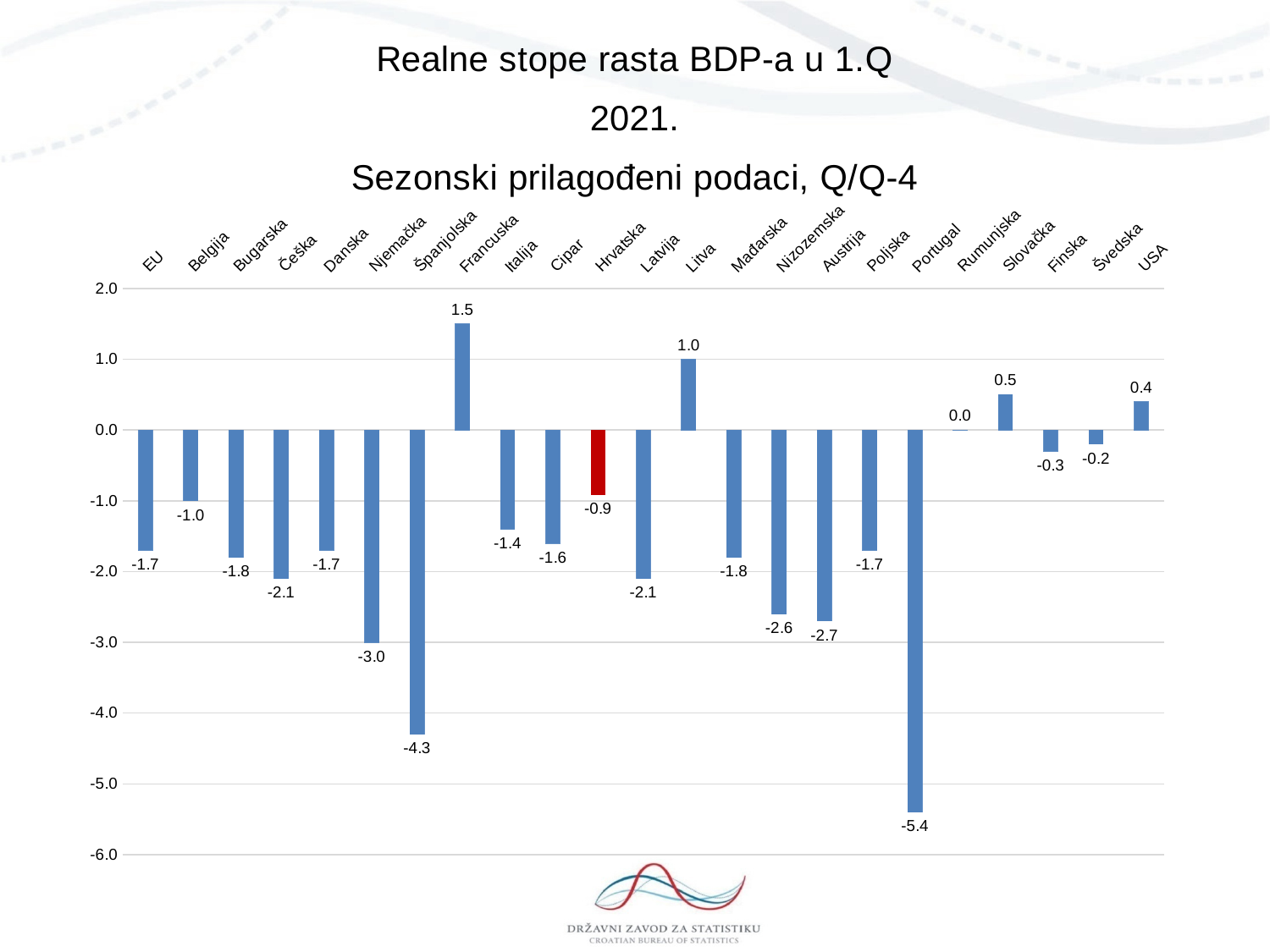
What is the difference between the values for Španjolska and Njemačka? 1.3 Which country has the lowest value? Portugal Which country has the highest value? Francuska Is the value for Nizozemska greater or less than -2.0? less What is the value for Francuska? 1.5 What is the value for Rumunjska? 0.0 Which bar is coloured red instead of blue? Hrvatska How many countries/regions are shown on the chart? 23 What kind of chart is shown on the slide? bar chart What is the value for Portugal? -5.4 What is the value for Hrvatska? -0.9 Which has the larger value, Litva or USA? Litva